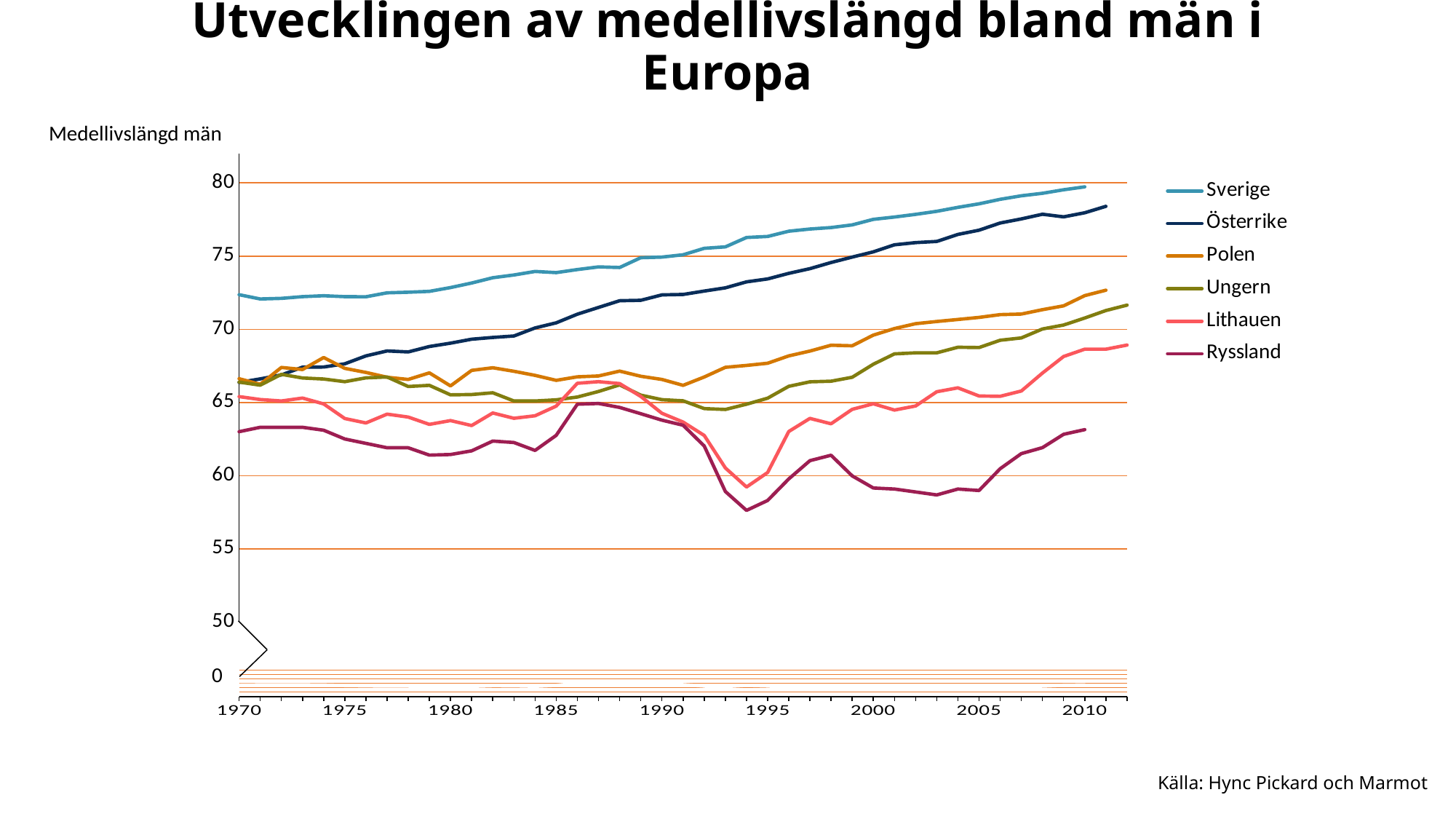
How many series does the legend list? 6 Is the value for Österrike in 1970 greater or less than 70? less Does the line for Sverige rise or fall from 1970 to 2010? rises Which country has the highest male life expectancy in 2010? Sverige Which country has the lowest male life expectancy in 1970? Ryssland Is the value for Sverige in 2010 greater or less than 75? greater Is the value for Polen in 2010 greater or less than 70? greater Which country has the lowest male life expectancy in 2010? Ryssland What is the title of the chart? Utvecklingen av medellivslängd bland män i Europa Which is larger in 2000, the value for Österrike or the value for Polen? Österrike What kind of chart is shown on the slide? line chart